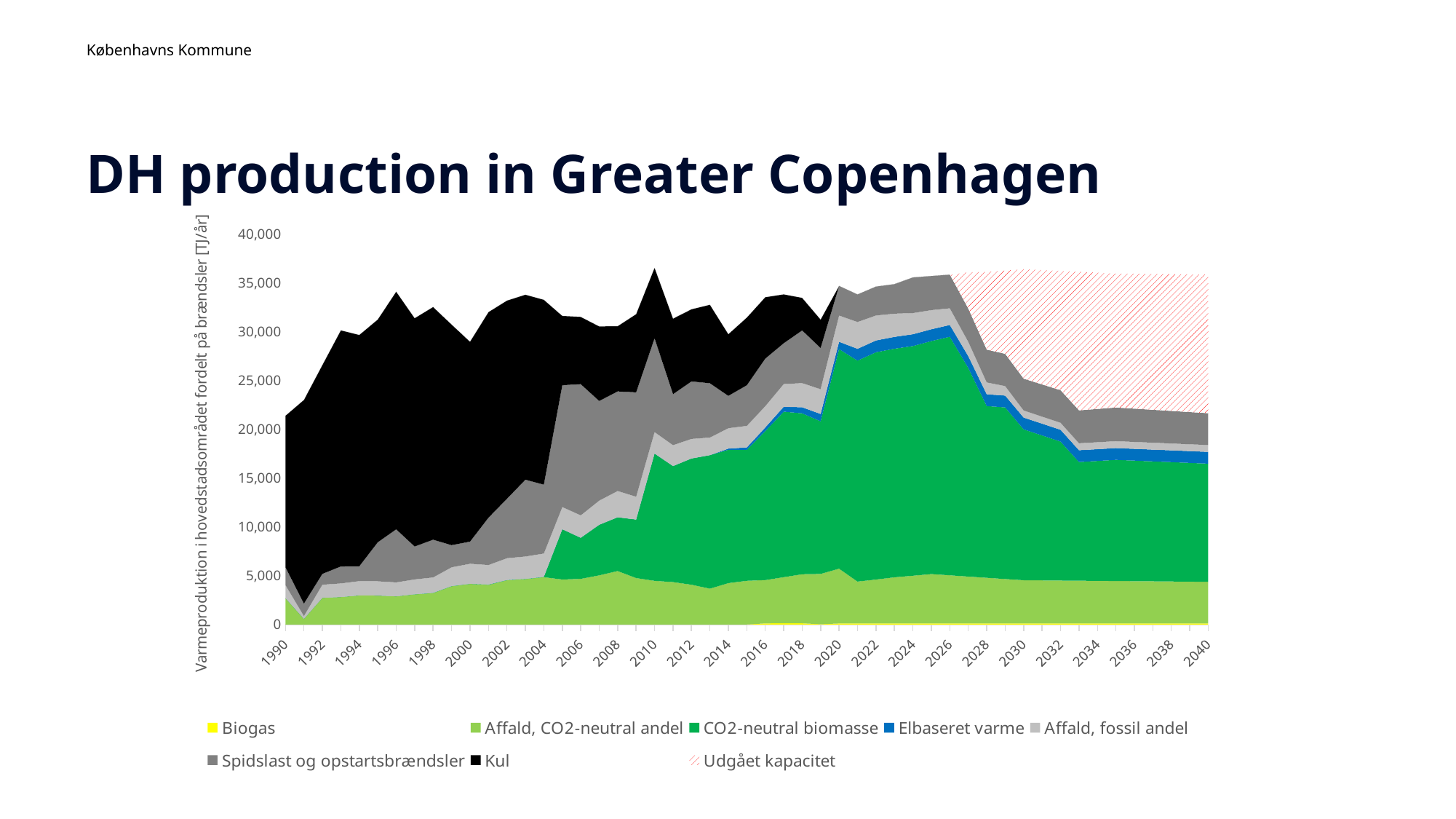
What is the first year shown on the x axis? 1990 Is the total stacked value in 1991 greater or less than 20,000? greater What is the title of the chart? DH production in Greater Copenhagen What is the last year shown on the x axis? 2040 Is the total stacked value in 2010 greater or less than 35,000? greater What kind of chart is shown on the slide? Stacked area chart Does the CO2-neutral biomasse series rise or fall between 2004 and 2026? Rise What is the highest value shown on the y axis? 40,000 Which series is drawn with red hatching? Udgået kapacitet How many series does the legend list? 8 Does the Kul (coal) series rise or fall between 1990 and 2020? Fall Is the value for Affald, CO2-neutral andel in 2040 greater or less than 5,000? less